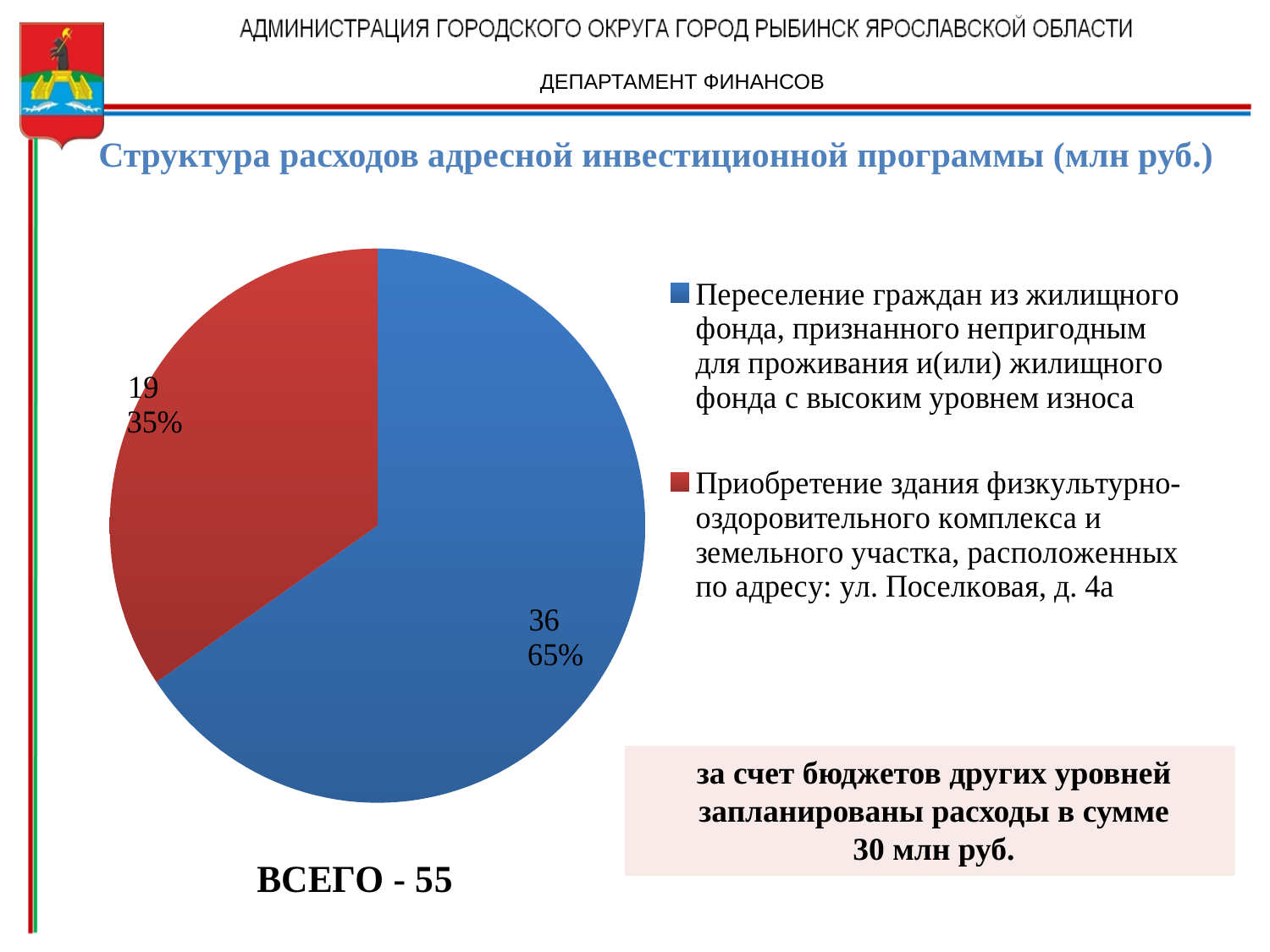
What share of the pie does the 'Приобретение здания физкультурно-оздоровительного комплекса...' slice represent? 35% What share of the pie does the 'Переселение граждан...' slice represent? 65% What is the total of all slices in the pie chart? 55 What is the value for 'Переселение граждан из жилищного фонда, признанного непригодным для проживания и(или) жилищного фонда с высоким уровнем износа'? 36 What is the value for 'Приобретение здания физкультурно-оздоровительного комплекса и земельного участка, расположенных по адресу: ул. Поселковая, д. 4а'? 19 Which category has the smallest slice of the pie? Приобретение здания физкультурно-оздоровительного комплекса и земельного участка, расположенных по адресу: ул. Поселковая, д. 4а How many slices does the pie chart have? 2 Which category has the largest slice of the pie? Переселение граждан из жилищного фонда, признанного непригодным для проживания и(или) жилищного фонда с высоким уровнем износа Which is larger: the value for 'Переселение граждан...' or the value for 'Приобретение здания...'? Переселение граждан... What is the difference between the value for 'Переселение граждан...' and the value for 'Приобретение здания...'? 17 What colour is the slice for 'Приобретение здания физкультурно-оздоровительного комплекса...'? red What type of chart is shown on the slide? pie chart